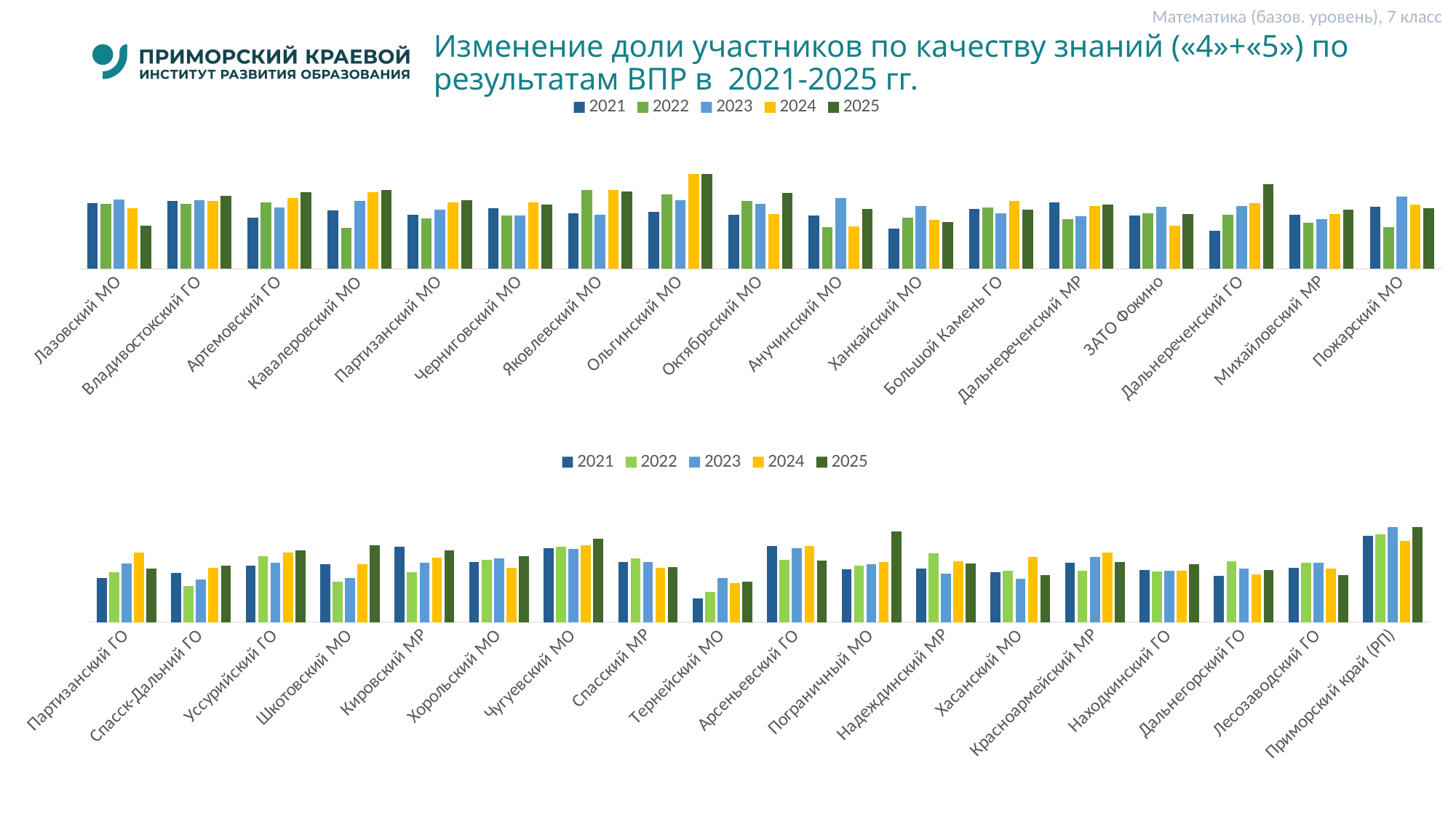
In the top chart, how many categories (municipalities) are shown on the x axis? 17 In the bottom chart, which year has the lowest value for Тернейский МО? 2021 In the top chart, is the value for Ольгинский МО larger in 2021 or in 2025? 2025 In the top chart, does the value for Дальнереченский ГО rise or fall from 2021 to 2025? rise In the top chart, which year has the highest value for Анучинский МО? 2023 In the top chart, which year has the lowest value for Лазовский МО? 2025 What kind of chart is the top chart on the slide? bar chart How many series does the legend of the top chart list? 5 In the top chart, which year has the lowest value for Кавалеровский МО? 2022 In the bottom chart, is the value for Приморский край (РП) larger in 2023 or in 2024? 2023 In the bottom chart, how many categories are shown on the x axis? 18 In the bottom chart, which year has the highest value for Пограничный МО? 2025